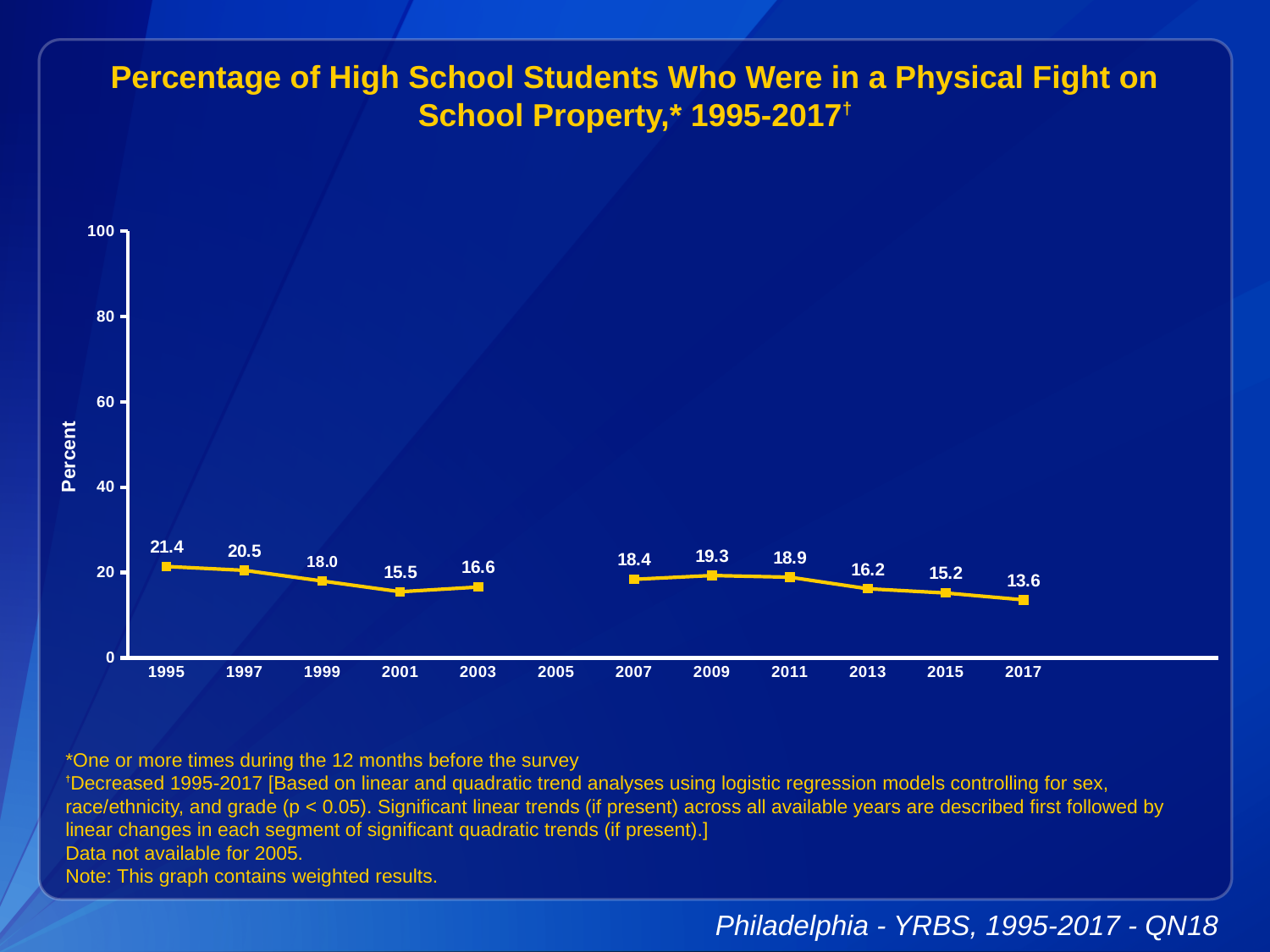
What was the percentage of high school students who were in a physical fight on school property in 1995? 21.4 What value is shown for 2017? 13.6 What value is shown for 2009? 19.3 Which is larger, the value for 2001 or the value for 2003? 2003 Overall, do the values rise or fall from 1995 to 2017? fall Which year on the x axis has no data point plotted? 2005 Is the value for 2013 greater or less than 20? less What is the difference between the 1995 value and the 2017 value? 7.8 How many years have data points plotted on the chart? 11 Which year has the lowest percentage? 2017 Which year has the highest percentage? 1995 What kind of chart is shown on the slide? line chart